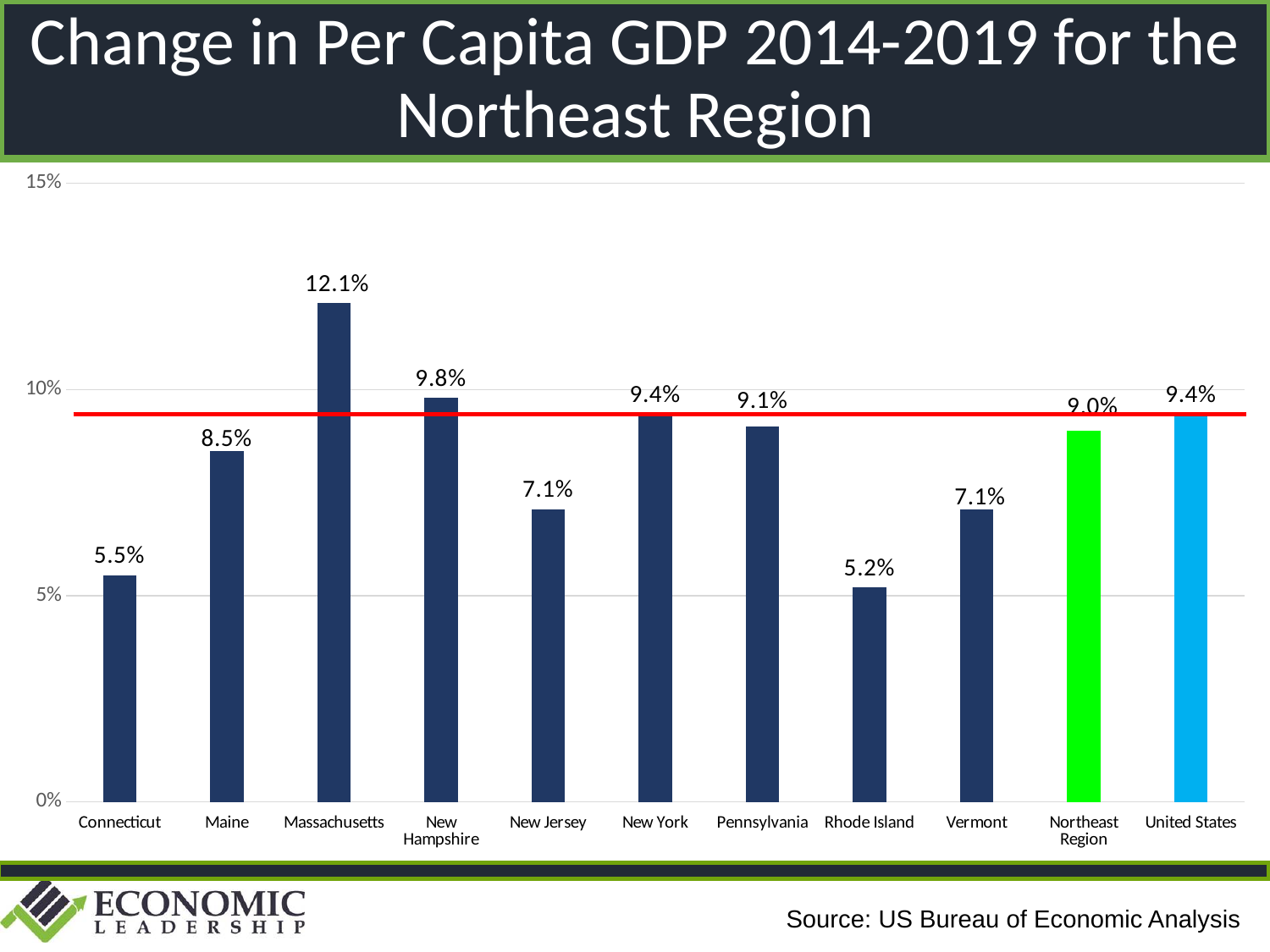
What kind of chart is shown on the slide? bar chart What is the difference between the values for Massachusetts and Connecticut? 6.6% Is the value for New Hampshire greater or less than 10%? less Which category has the lowest change in per capita GDP? Rhode Island What is the value shown for Rhode Island? 5.2% What is the difference between the values for the United States and the Northeast Region? 0.4% What is the change in per capita GDP for Massachusetts? 12.1% How many categories are shown on the x axis? 11 Which is larger, the value for Maine or the value for New Jersey? Maine Which category has the highest change in per capita GDP? Massachusetts What is the value shown for the Northeast Region? 9.0% What colour is the bar for the United States? light blue